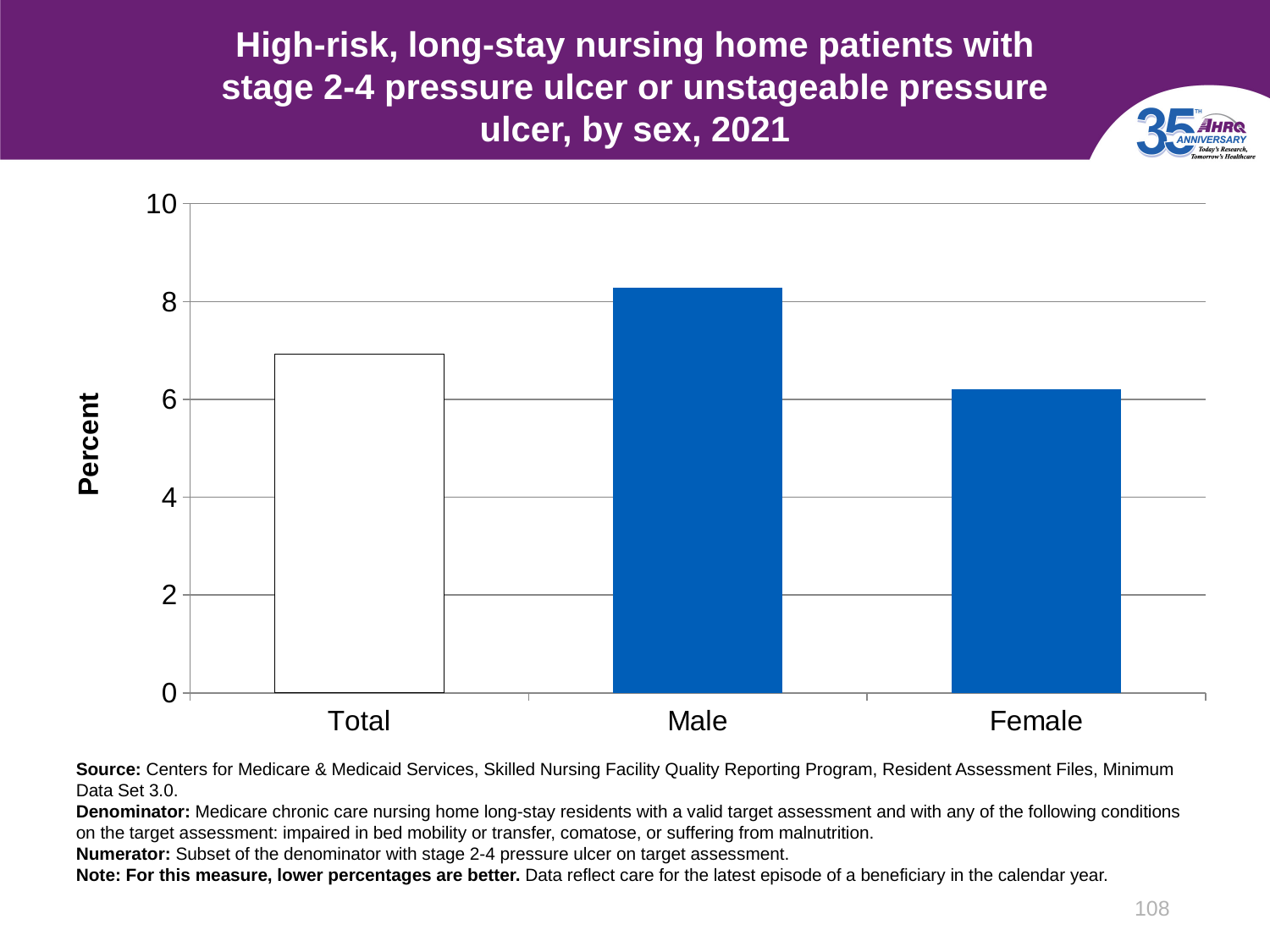
Which is larger, the value for Male or the value for Total? Male How many categories are shown on the x axis of the chart? 3 Which is larger, the value for Total or the value for Female? Total What is the maximum value shown on the y axis of the chart? 10 What kind of chart is shown on the slide? bar chart Is the value for Female greater or less than 8? less Which category has the highest value in the chart? Male Is the value for Total greater or less than 6? greater Which category has the lowest value in the chart? Female Is the value for Total greater or less than 8? less What is the label on the y axis of the chart? Percent